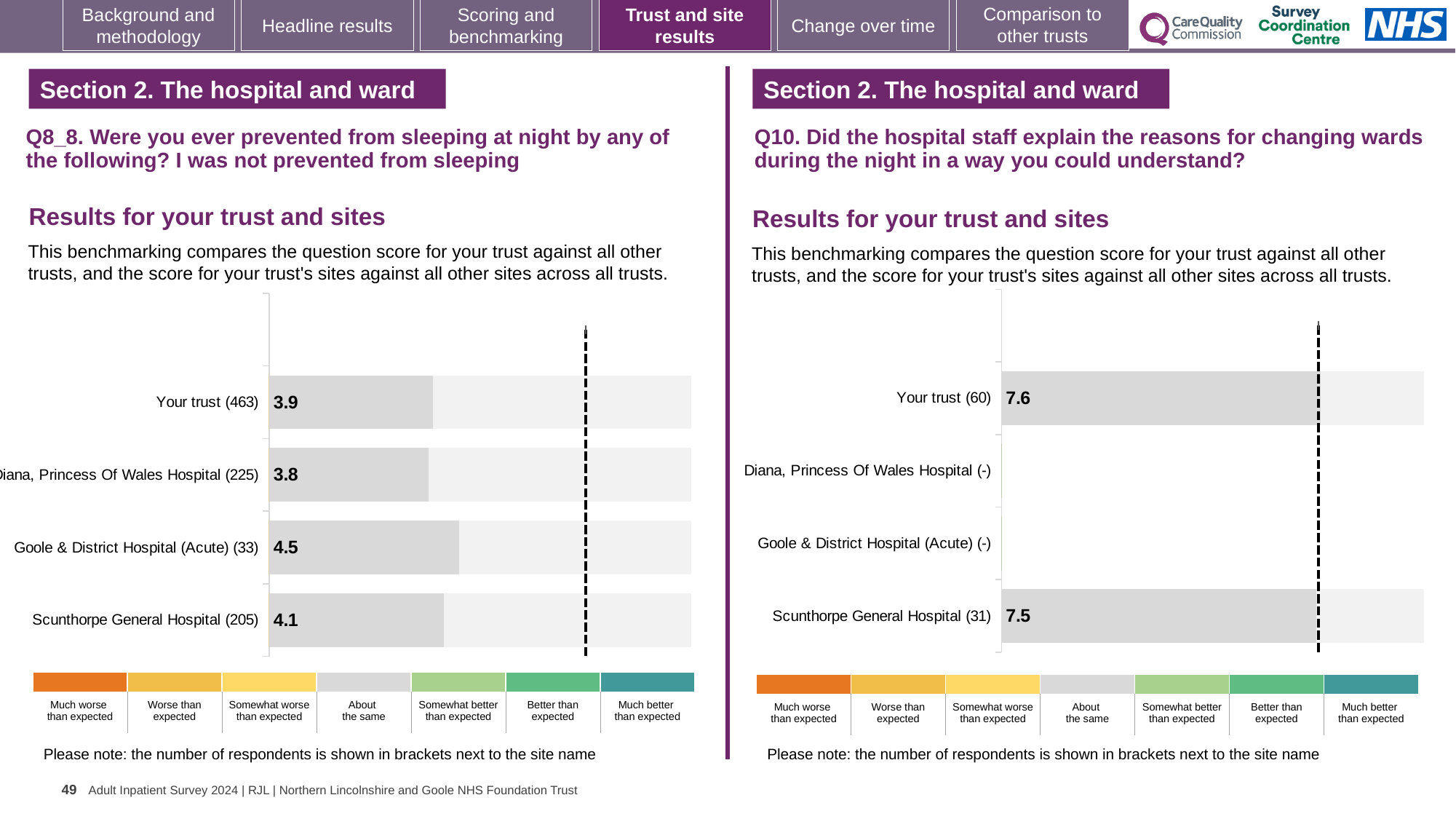
On the Q8_8 chart (left), what is the score for Your trust (463)? 3.9 On the Q10 chart (right), what is the difference between the scores for Your trust and Scunthorpe General Hospital? 0.1 On the Q8_8 chart (left), what is the score for Scunthorpe General Hospital (205)? 4.1 On the Q8_8 chart (left), which site or trust has the highest score? Goole & District Hospital (Acute) (33) On the Q8_8 chart (left), what is the difference between the scores for Goole & District Hospital (Acute) and Your trust? 0.6 On the Q10 chart (right), what is the score for Scunthorpe General Hospital (31)? 7.5 On the Q8_8 chart (left), what is the score for Goole & District Hospital (Acute) (33)? 4.5 On the Q10 chart (right), how many sites show no score (marked with a dash)? 2 What type of chart is used on the Q8_8 chart (left)? Bar chart On the Q8_8 chart (left), how many bars are plotted? 4 On the Q10 chart (right), what is the score for Your trust (60)? 7.6 On the Q8_8 chart (left), which site or trust has the lowest score? Diana, Princess Of Wales Hospital (225)